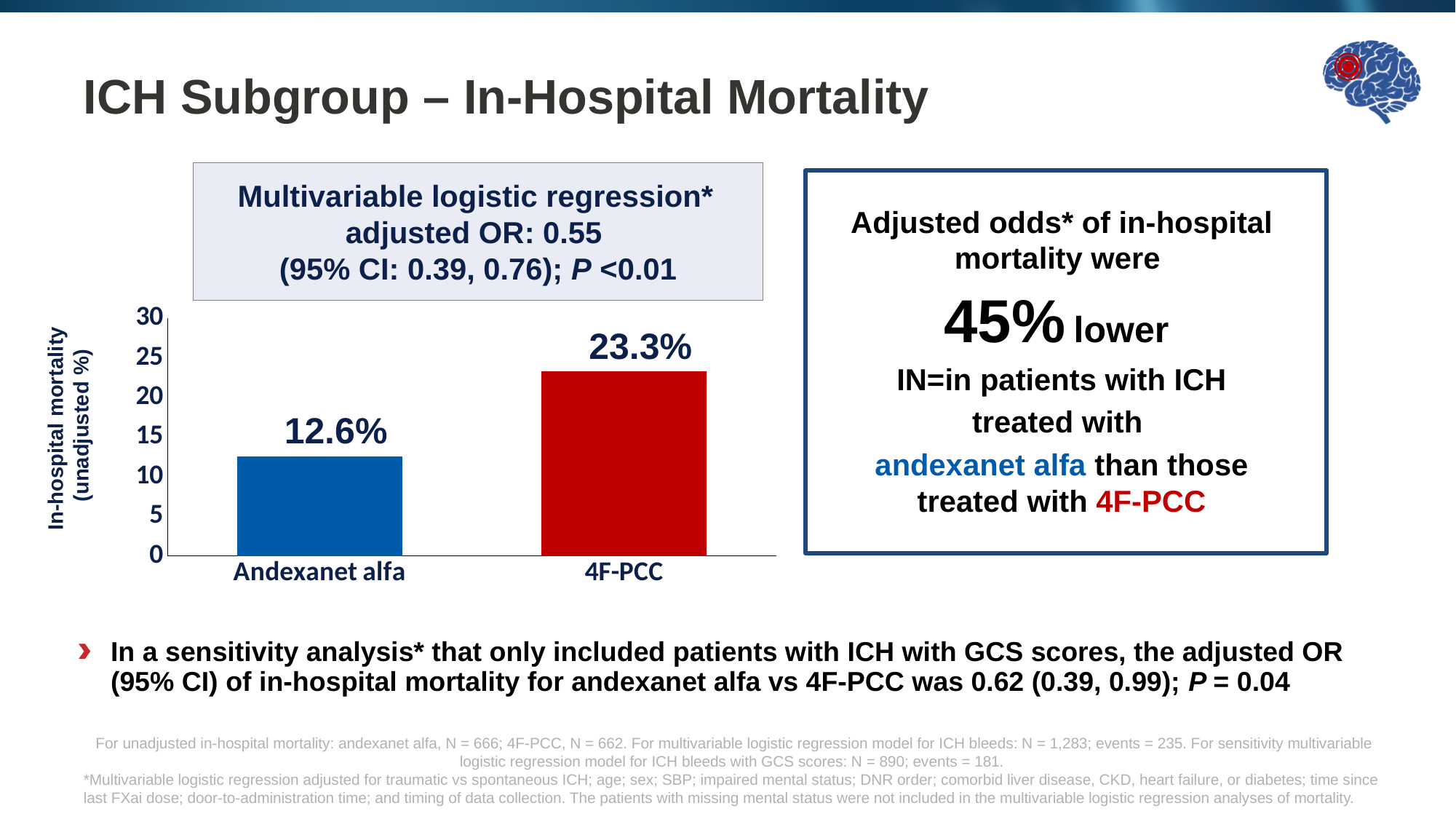
What kind of chart is shown on the slide? Bar chart Is the in-hospital mortality higher for Andexanet alfa or 4F-PCC? 4F-PCC Which category has the lower in-hospital mortality? Andexanet alfa Which category has the higher in-hospital mortality? 4F-PCC Is the value for 4F-PCC greater or less than 20? greater What colour is the bar for 4F-PCC? Red How many categories are shown in the chart? 2 What is the in-hospital mortality for 4F-PCC? 23.3% What is the difference in in-hospital mortality between 4F-PCC and Andexanet alfa? 10.7% Is the value for Andexanet alfa greater or less than 15? less What is the in-hospital mortality for Andexanet alfa? 12.6% What is the label of the y axis? In-hospital mortality (unadjusted %)